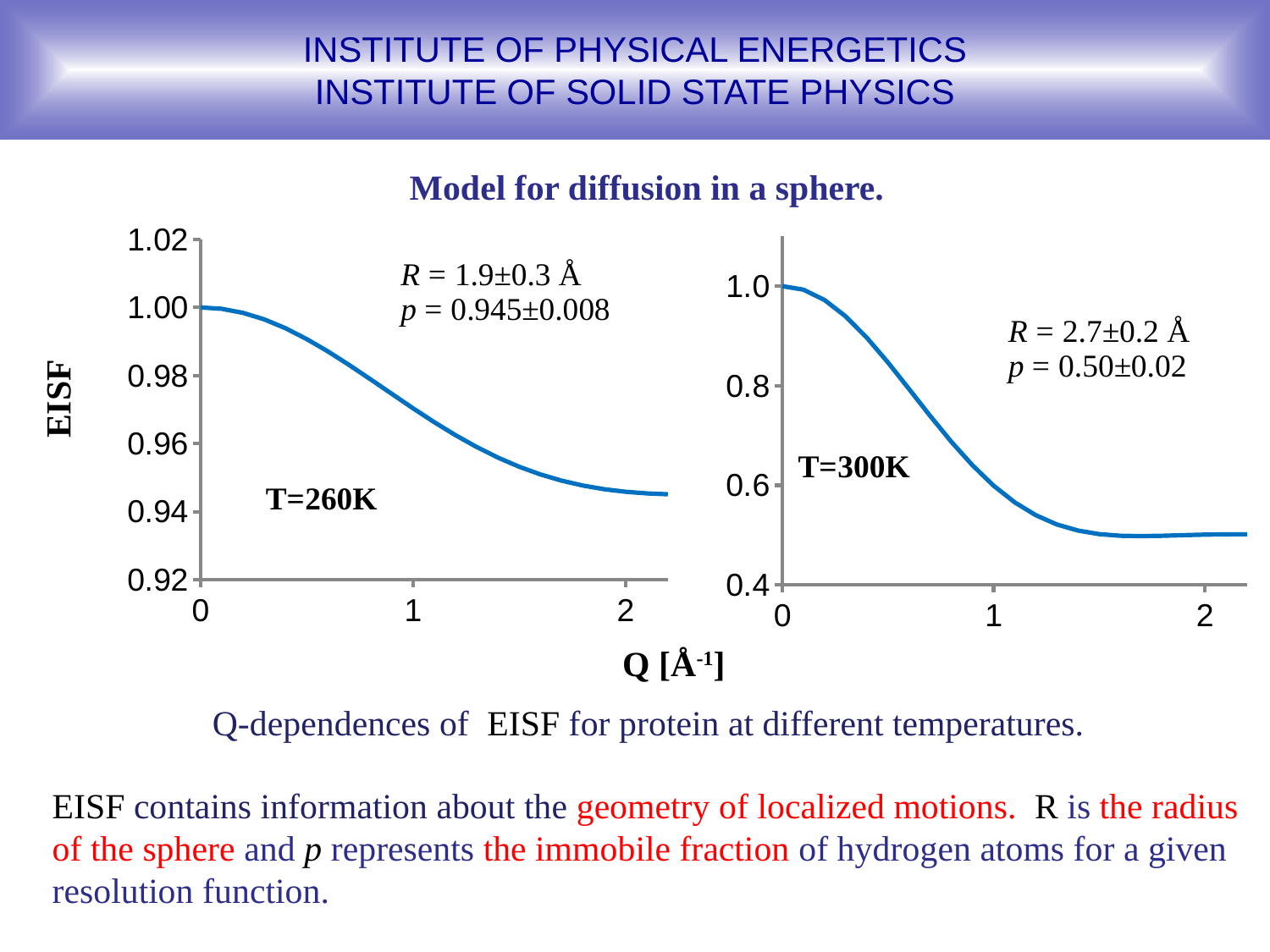
In the T=300K chart on the right, does EISF rise or fall as Q increases? fall In the T=300K chart on the right, what is the EISF value at Q = 0? 1.0 How many charts are shown on the slide? 2 In the T=260K chart on the left, does EISF rise or fall as Q increases? fall In the T=260K chart on the left, what is the EISF value at Q = 0? 1.00 In the T=300K chart on the right, is the EISF value at Q = 2 greater or less than 0.6? less What kind of chart is the T=260K chart on the left? line chart In the T=260K chart on the left, what value of R is annotated? 1.9±0.3 Å In the T=300K chart on the right, is the EISF value at Q = 0.5 greater or less than 0.8? greater In the T=300K chart on the right, what value of p is annotated? 0.50±0.02 In the T=260K chart on the left, is the EISF value at Q = 1 greater or less than 0.98? less